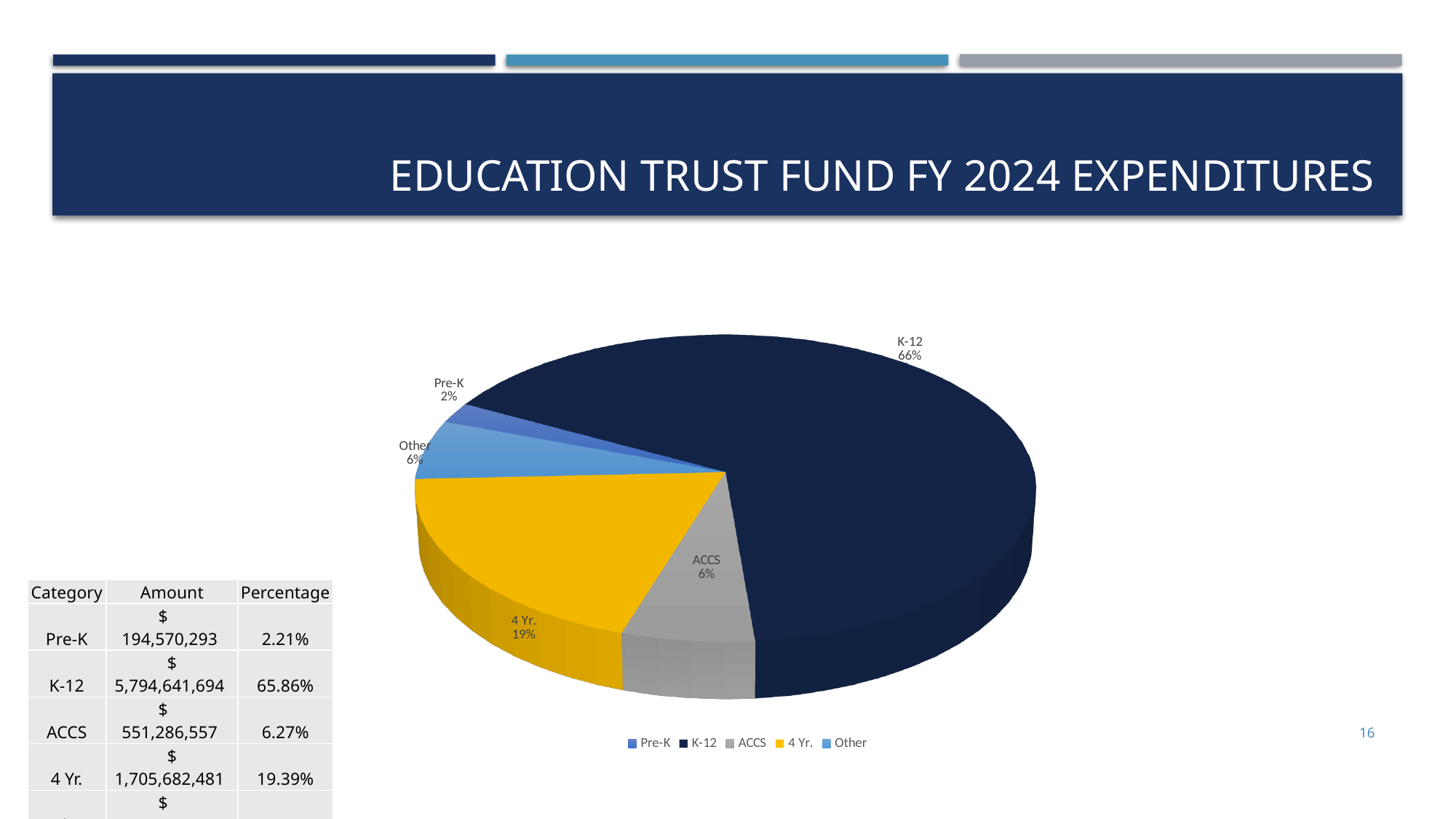
Which category has the smallest slice of the pie? Pre-K Which slice is larger, 4 Yr. or Other? 4 Yr. What percentage of the pie does the ACCS slice represent? 6% What percentage of the pie does the K-12 slice represent? 66% What percentage of the pie does the 4 Yr. slice represent? 19% What is the difference in percentage points between the K-12 slice and the 4 Yr. slice? 47 Which category has the largest slice of the pie? K-12 How many slices does the pie chart have? 5 What colour is the 4 Yr. slice in the pie chart? Yellow What type of chart is shown on the slide? Pie chart How many entries does the legend list? 5